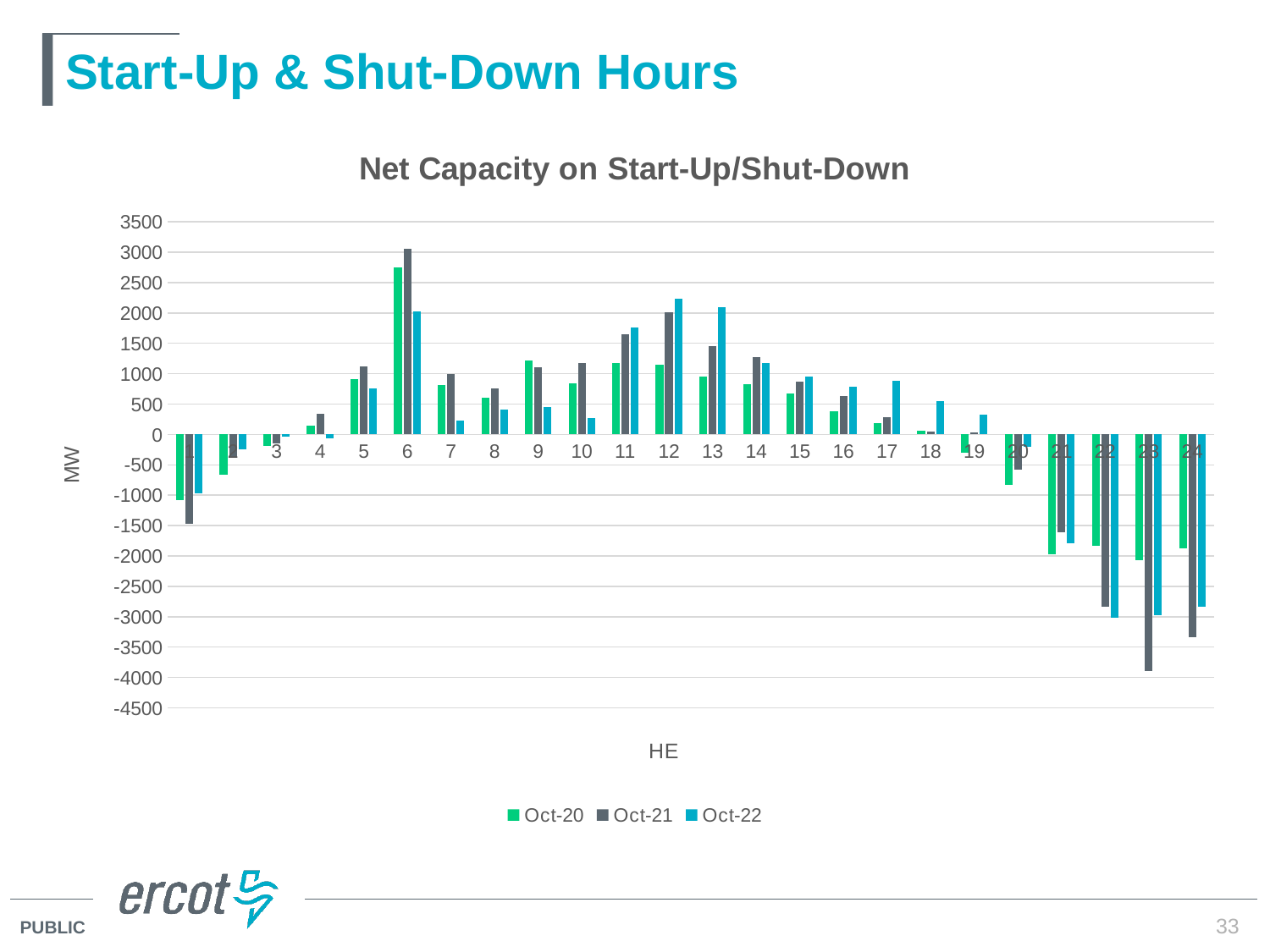
How many series does the legend list? 3 At HE 13, which of the three series has the highest value? Oct-22 Is the Oct-20 value at HE 22 greater or less than -1500? less At which hour (HE) does the Oct-21 series reach its lowest value? 23 Is the Oct-22 value at HE 12 greater or less than 2000? greater Is the Oct-21 value at HE 6 greater or less than 2500? greater At which hour (HE) does the Oct-21 series reach its highest value? 6 At HE 6, which series has the larger value, Oct-20 or Oct-22? Oct-20 How many hours (HE categories) are plotted along the x axis? 24 What kind of chart is shown on the slide? bar chart What is the label on the vertical axis of the chart? MW